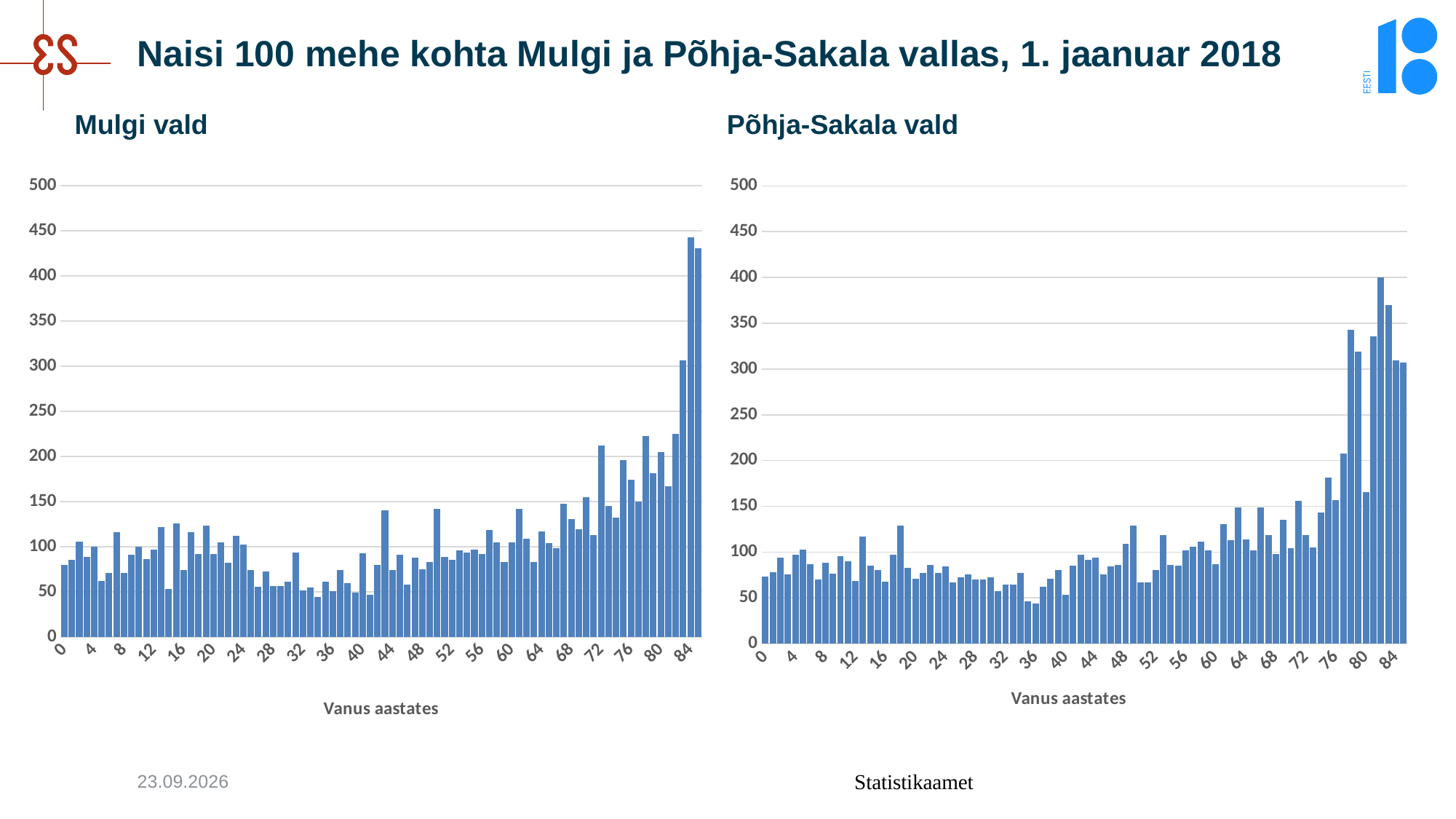
In the Põhja-Sakala vald chart, is the value for age 82 greater or less than 350? greater In the Põhja-Sakala vald chart, do the values generally rise or fall as age increases from 60 to 82? rise What is the x-axis label on the Põhja-Sakala vald chart? Vanus aastates In the Mulgi vald chart, is the value for age 0 greater or less than 100? less What kind of chart is the Mulgi vald chart? bar chart In the Mulgi vald chart, is the value for age 72 greater or less than 200? greater What are the titles of the two charts on the slide? Mulgi vald and Põhja-Sakala vald In the Mulgi vald chart, which is larger, the value for age 72 or the value for age 60? age 72 In the Põhja-Sakala vald chart, which age has the highest value? 82 In the Põhja-Sakala vald chart, which is larger, the value for age 16 or the value for age 36? age 16